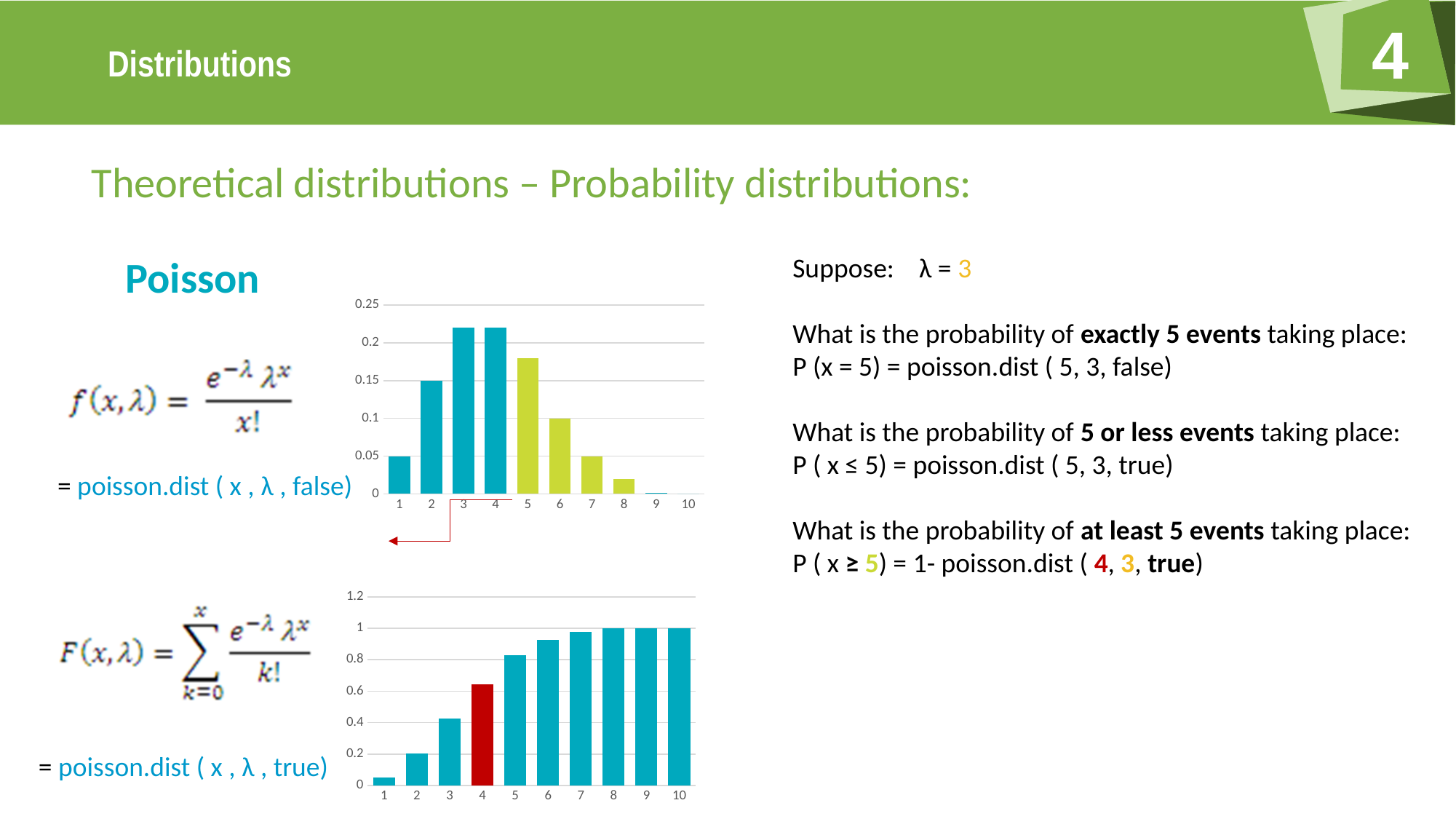
In the top chart, is the value for category 8 greater or less than 0.05? less How many categories are shown on the x axis of the bottom chart? 10 In the bottom chart, which category's bar is coloured red? 4 What kind of chart is the top chart on the slide? bar chart In the bottom chart, which category has the lowest value? 1 In the bottom chart, is the value for category 4 greater or less than 0.6? greater In the top chart, is the value for category 3 greater or less than 0.2? greater In the top chart, which is larger, the value for category 2 or the value for category 6? category 2 In the bottom chart, do the values rise or fall as the x axis goes from 1 to 10? rise In the top chart, which categories have yellow-green bars instead of blue? 5, 6, 7, 8